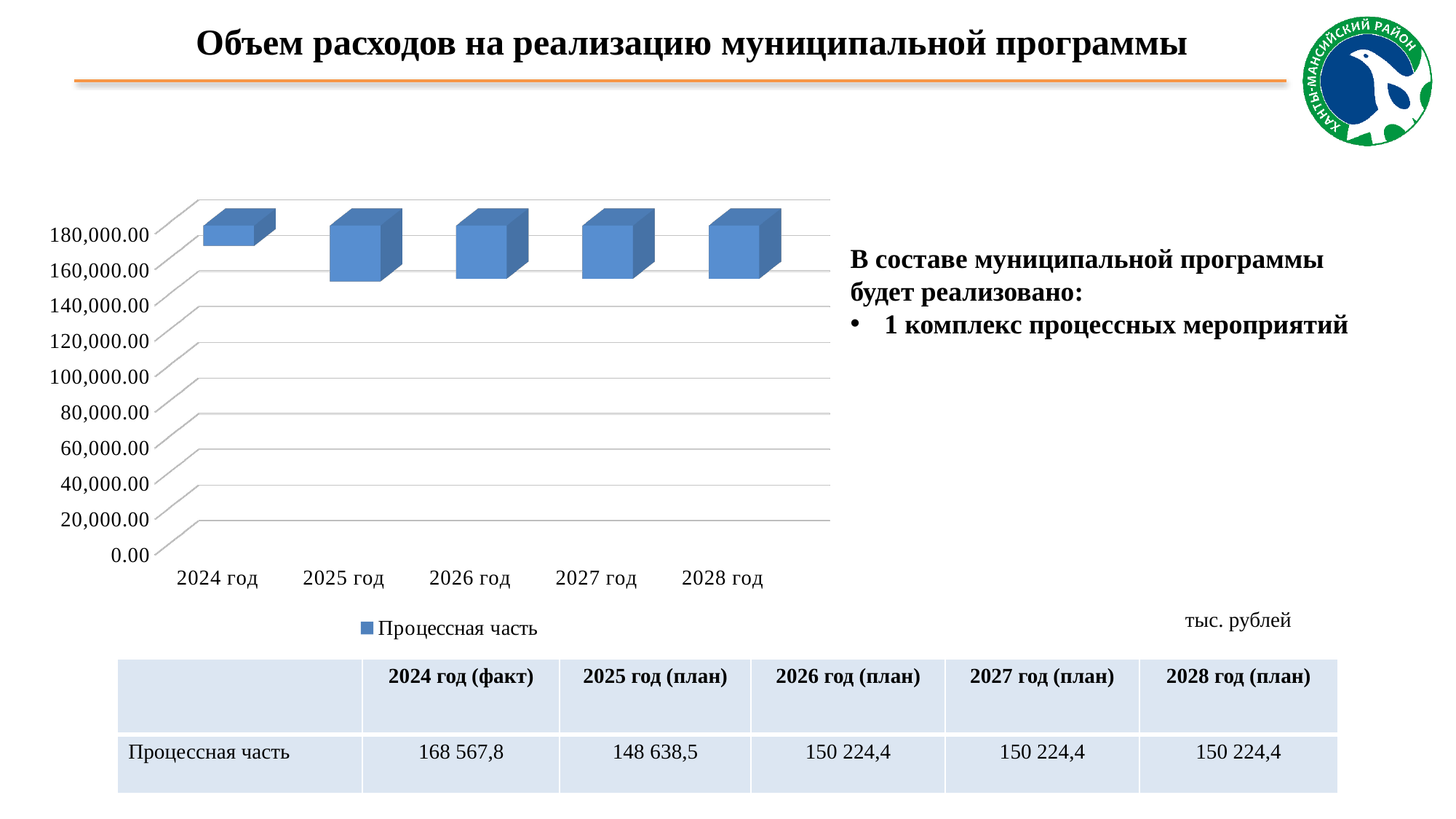
What is the name of the series shown in the chart legend? Процессная часть According to the table under the chart, what is the value of Процессная часть for 2025 год (план)? 148 638,5 According to the table under the chart, what is the value of Процессная часть for 2024 год (факт)? 168 567,8 Which year has the highest value of Процессная часть? 2024 год Which year has the lowest value of Процессная часть? 2025 год What type of chart is shown on the slide? bar chart What is the difference between the Процессная часть values for 2024 год and 2025 год? 19 929,3 What is the title of the slide containing the chart? Объем расходов на реализацию муниципальной программы According to the table under the chart, what is the value of Процессная часть for 2027 год (план)? 150 224,4 How many series does the chart legend list? 1 How many categories (years) are shown on the x axis of the chart? 5 Does the value of Процессная часть rise or fall from 2024 год to 2025 год? fall